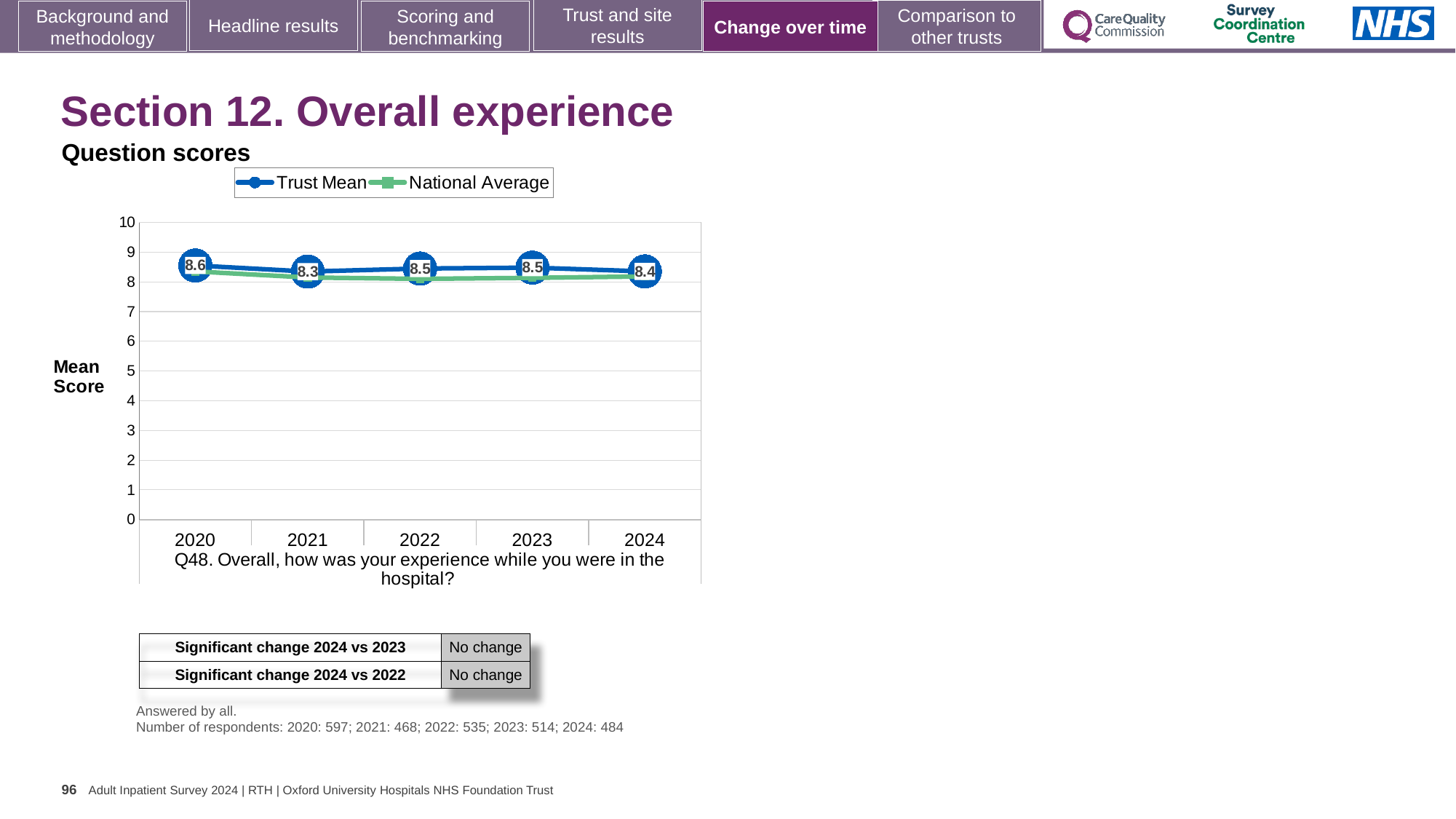
Which is larger, the Trust Mean score for 2022 or for 2024? 2022 What kind of chart is shown? Line chart How many years are plotted on the x axis? 5 How many series does the legend list? 2 In which year is the Trust Mean score highest? 2020 Does the Trust Mean score rise or fall from 2020 to 2021? Fall What is the Trust Mean score for 2021? 8.3 What is the Trust Mean score for 2024? 8.4 Is the National Average value for 2021 greater or less than 9? less In which year is the Trust Mean score lowest? 2021 What is the Trust Mean score for 2020? 8.6 What is the difference between the Trust Mean scores for 2020 and 2021? 0.3